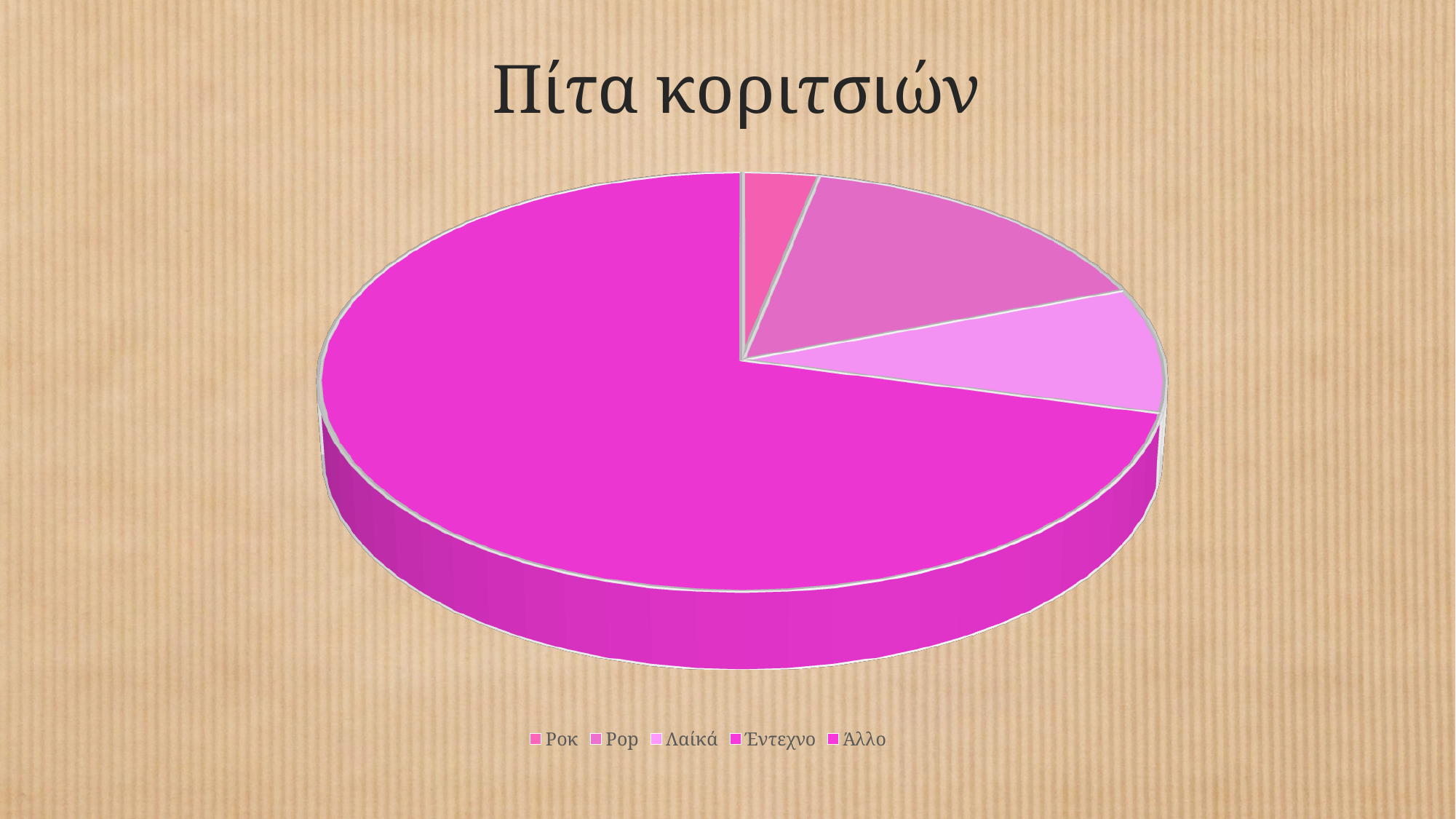
Which slice is larger, Pop or Ροκ? Pop What kind of chart is shown on the slide? pie chart Which category is listed first in the legend? Ροκ What is the title of the chart? Πίτα κοριτσιών Which slice is larger, Λαϊκά or Ροκ? Λαϊκά How many categories does the pie chart's legend list? 5 Is the Ροκ slice larger or smaller than the Pop slice? smaller